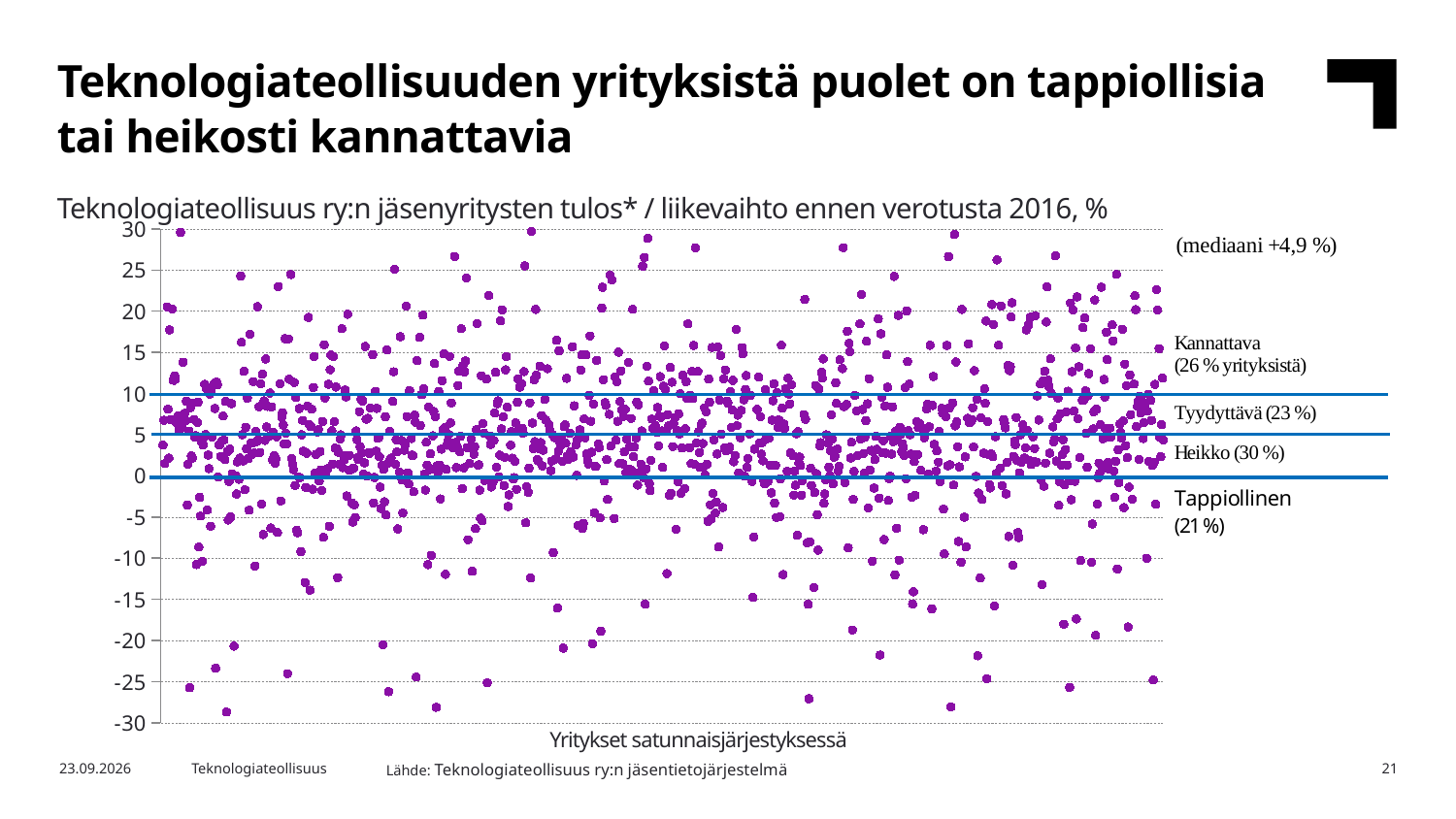
What share of companies is in the Tappiollinen group? 21 % Which profitability group contains the largest share of companies? Heikko What is the median value of tulos / liikevaihto stated on the chart? +4,9 % What share of companies is in the Kannattava group according to the chart? 26 % What is the label of the x axis? Yritykset satunnaisjärjestyksessä What is the highest value shown on the y axis? 30 What share of companies is in the Heikko group? 30 % How many percentage points larger is the Heikko share than the Tappiollinen share? 9 Which profitability group contains the smallest share of companies? Tappiollinen What share of companies is in the Tyydyttävä group? 23 % Which group has a larger share of companies, Kannattava or Tyydyttävä? Kannattava What kind of chart is shown on the slide? Scatter chart